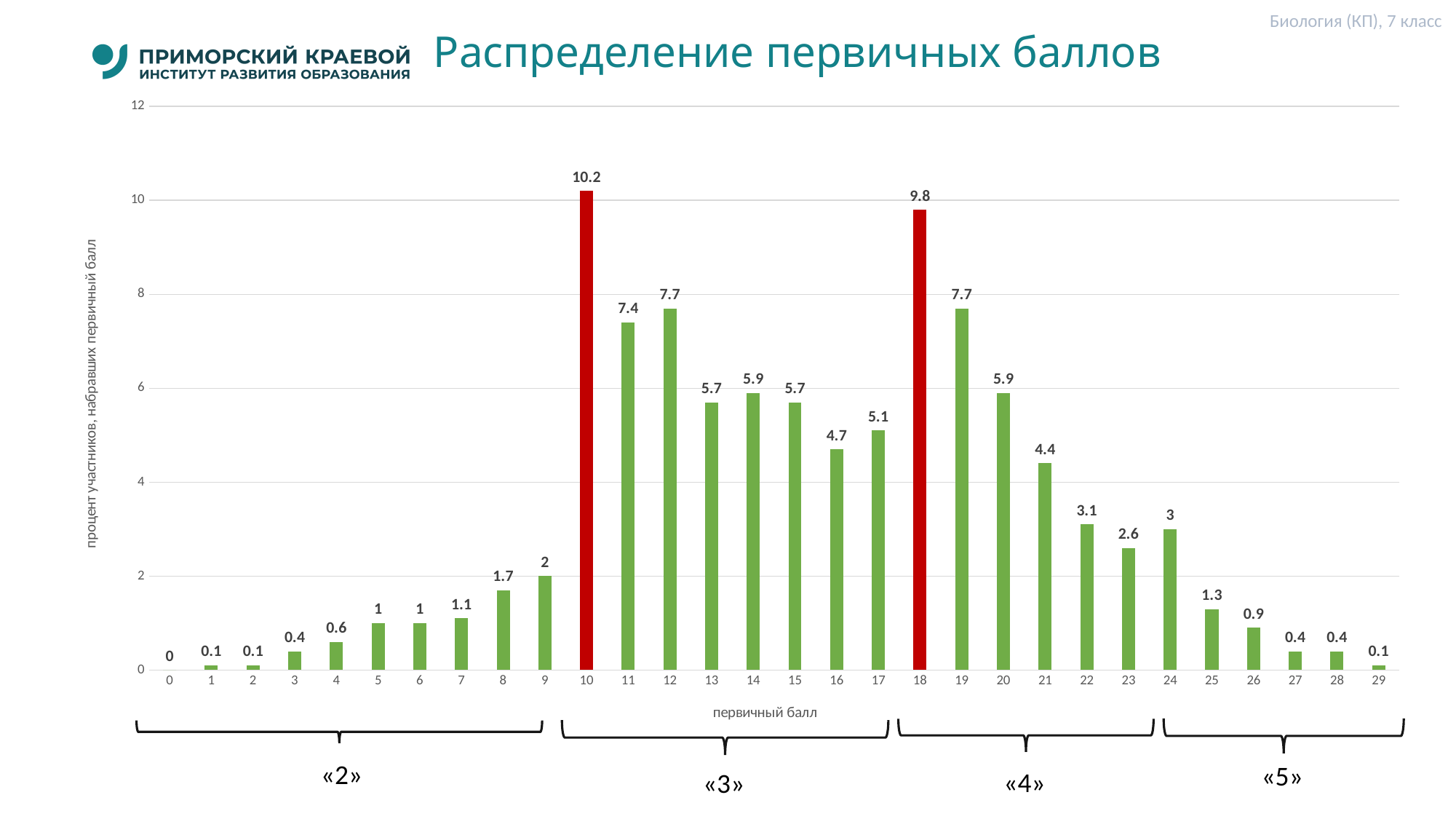
What is the value for primary score 10? 10.2 What kind of chart is shown on the slide? bar chart Is the value for primary score 19 greater or less than 6? greater Which has a larger value, primary score 11 or primary score 12? 12 What is the value for primary score 24? 3 Which primary score has the lowest percentage of participants? 0 What is the difference between the values for primary scores 10 and 18? 0.4 What is the value for primary score 18? 9.8 Do the values rise or fall along the x axis from primary score 18 to 29? fall (with a small rise at 24) Which two primary scores are highlighted with red bars? 10 and 18 How many primary score categories are shown on the x axis? 30 Which primary score has the highest percentage of participants? 10